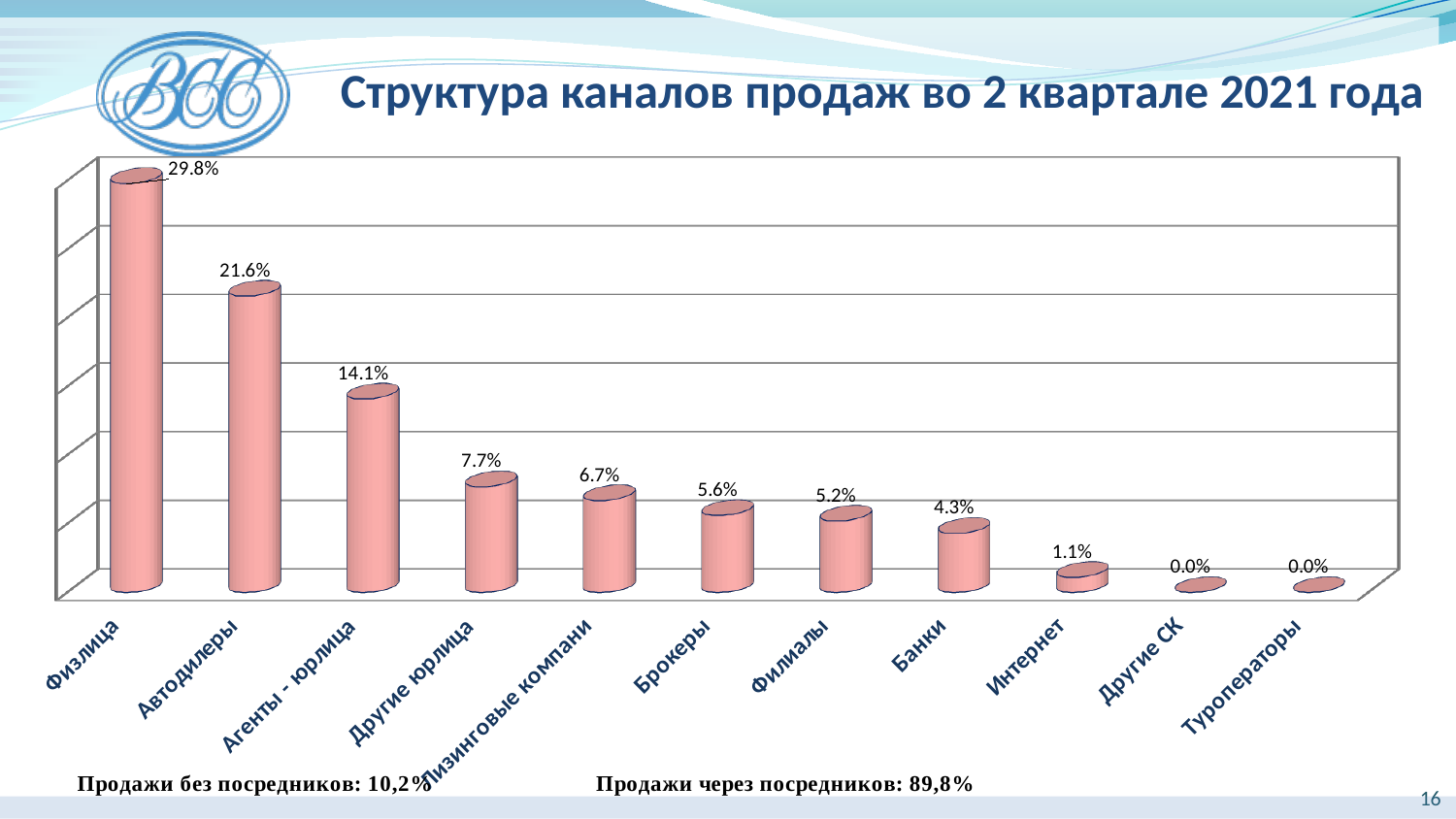
Do the values rise or fall from left to right along the x axis? Fall What is the value for Автодилеры? 21.6% Which category has the highest value? Физлица What kind of chart is shown on the slide? Bar chart What is the value for Интернет? 1.1% What is the difference between the values for Агенты - юрлица and Другие юрлица? 6.4% What is the title of the chart? Структура каналов продаж во 2 квартале 2021 года What is the value for Физлица? 29.8% Which is larger, the value for Филиалы or the value for Банки? Филиалы How many categories are shown on the chart? 11 What is the difference between the values for Физлица and Автодилеры? 8.2% What is the value for Брокеры? 5.6%